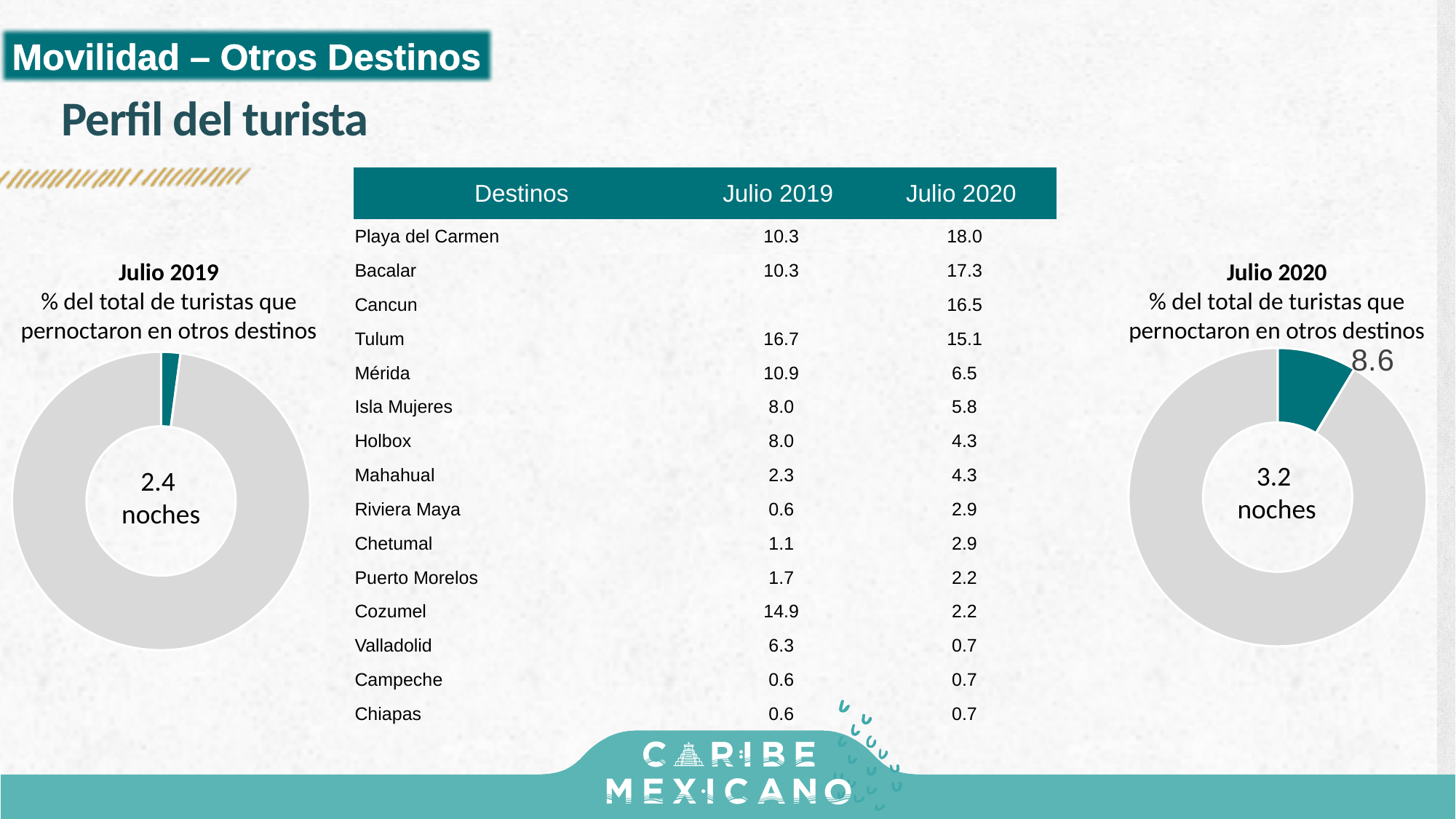
What text is shown in the centre of the Julio 2020 donut chart? 3.2 noches What is the difference in nights between the centre values of the Julio 2020 and Julio 2019 donut charts? 0.8 noches What text is shown in the centre of the Julio 2019 donut chart? 2.4 noches How many slices does the Julio 2020 donut chart have? 2 What is the subtitle printed under the 'Julio 2019' heading of the left donut chart? % del total de turistas que pernoctaron en otros destinos What kind of chart is used for the Julio 2019 and Julio 2020 figures on the slide? Donut (pie) chart Which donut chart has the larger highlighted slice, Julio 2019 or Julio 2020? Julio 2020 Which donut chart shows the higher number of nights in its centre, Julio 2019 or Julio 2020? Julio 2020 According to the Julio 2020 donut chart, what share of total tourists stayed overnight in other destinations? 8.6 What colour is the highlighted slice in the Julio 2020 donut chart? Teal In the Julio 2020 donut chart, what value is printed on the highlighted teal slice? 8.6